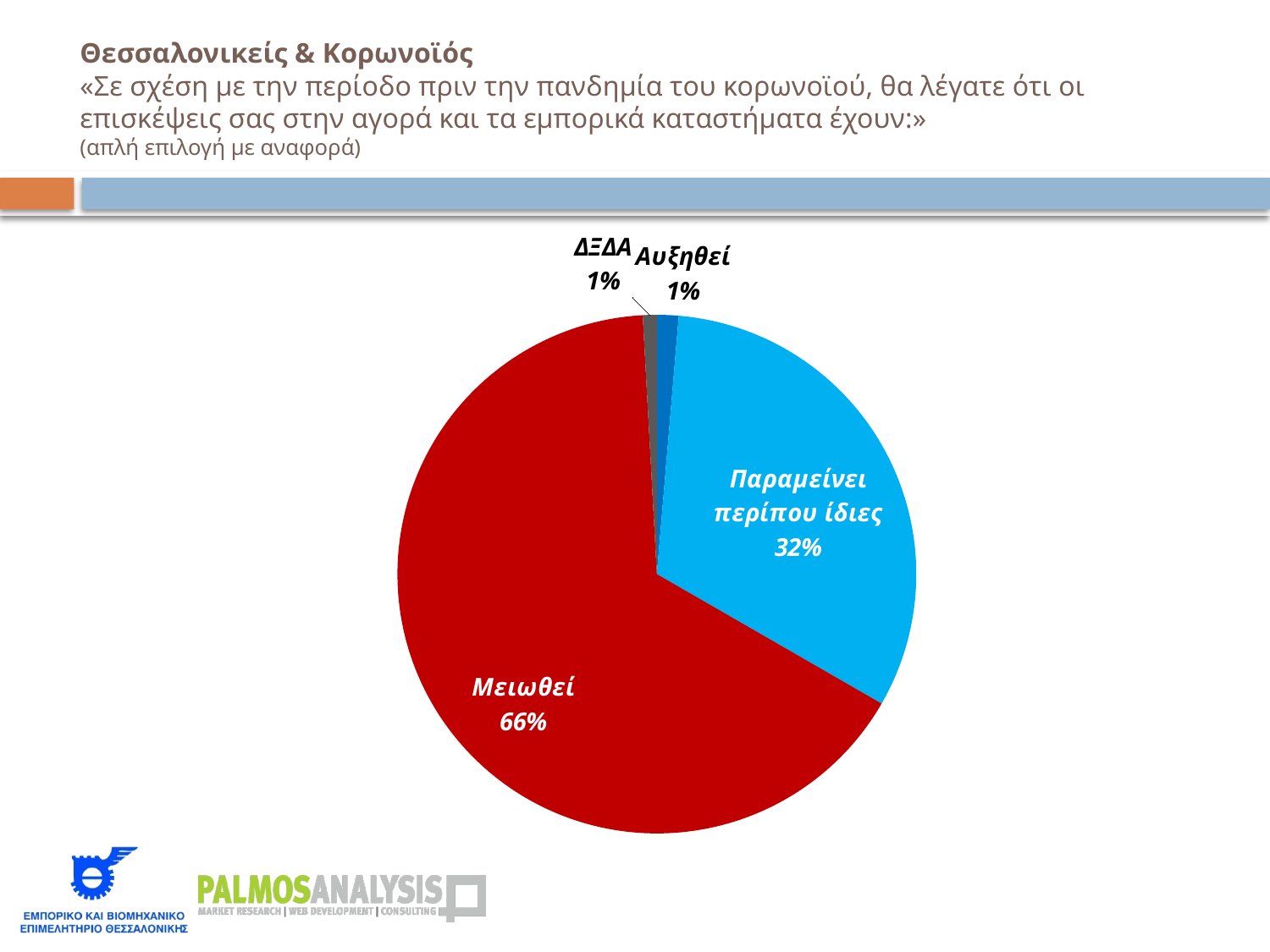
What percentage of respondents said their visits have remained about the same (Παραμείνει περίπου ίδιες)? 32% What percentage of respondents answered ΔΞΔΑ? 1% Which category has the largest share of the pie? Μειωθεί What kind of chart is shown on the slide? pie chart What is the combined share of Μειωθεί and Παραμείνει περίπου ίδιες? 98% What colour is the slice for Παραμείνει περίπου ίδιες? light blue What colour is the slice for Μειωθεί? red Which is larger, the share for Μειωθεί or the share for Παραμείνει περίπου ίδιες? Μειωθεί How many slices does the pie chart have? 4 What percentage of respondents said their visits have decreased (Μειωθεί)? 66% What is the difference in percentage points between Μειωθεί and Παραμείνει περίπου ίδιες? 34 What percentage of respondents said their visits have increased (Αυξηθεί)? 1%